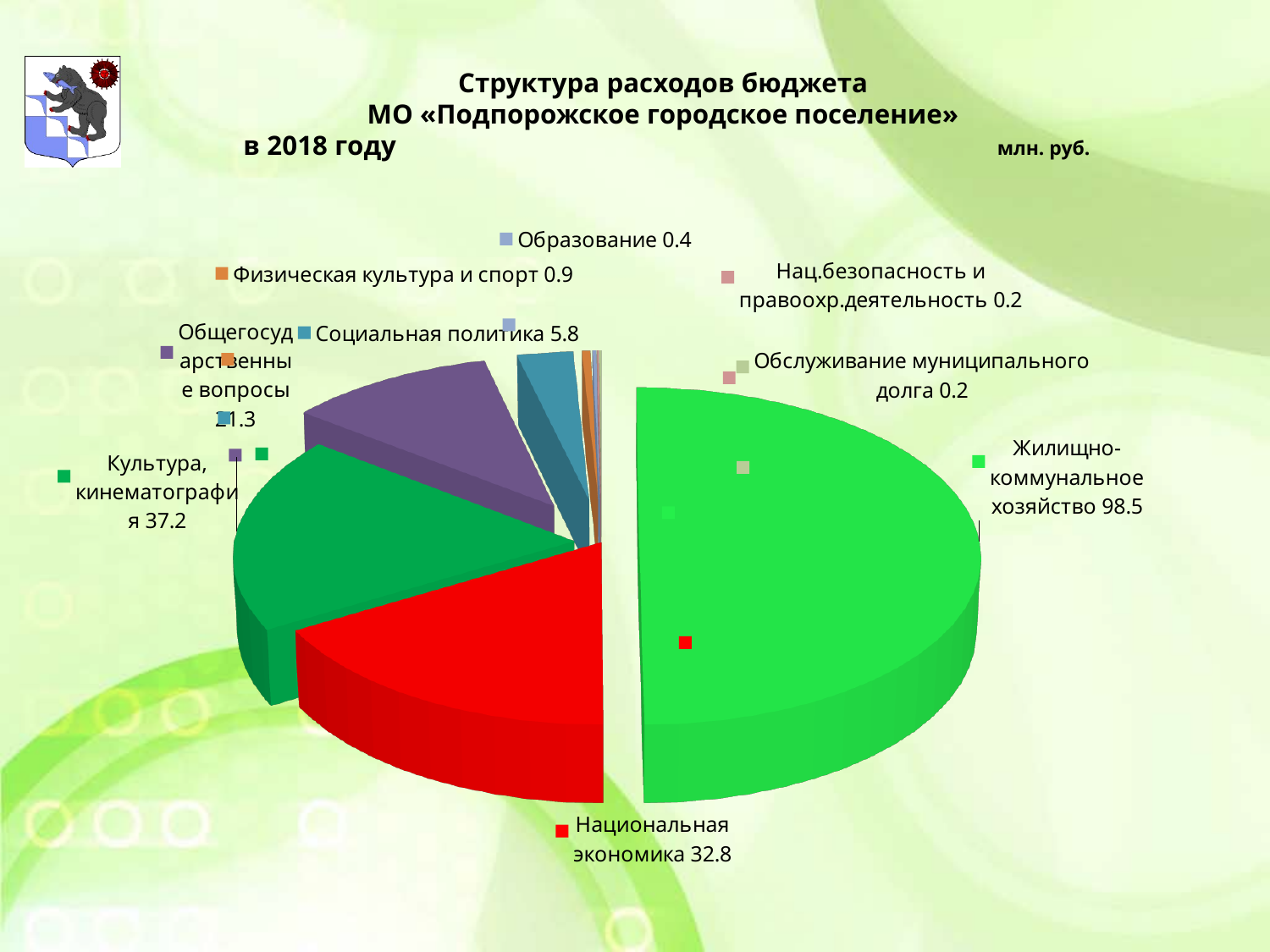
What is the value for Национальная экономика? 32.8 What kind of chart is shown on the slide? pie chart What is the value for Культура, кинематография? 37.2 Which expenditure category has the largest slice of the pie? Жилищно-коммунальное хозяйство What is the difference between the values for Культура, кинематография and Национальная экономика? 4.4 What is the difference between the values for Жилищно-коммунальное хозяйство and Культура, кинематография? 61.3 Which is larger: Физическая культура и спорт or Образование? Физическая культура и спорт What is the value for Жилищно-коммунальное хозяйство? 98.5 How many expenditure categories are shown in the pie chart? 9 In what units are the values on the chart given? млн. руб. What is the value for Образование? 0.4 What is the value for Социальная политика? 5.8